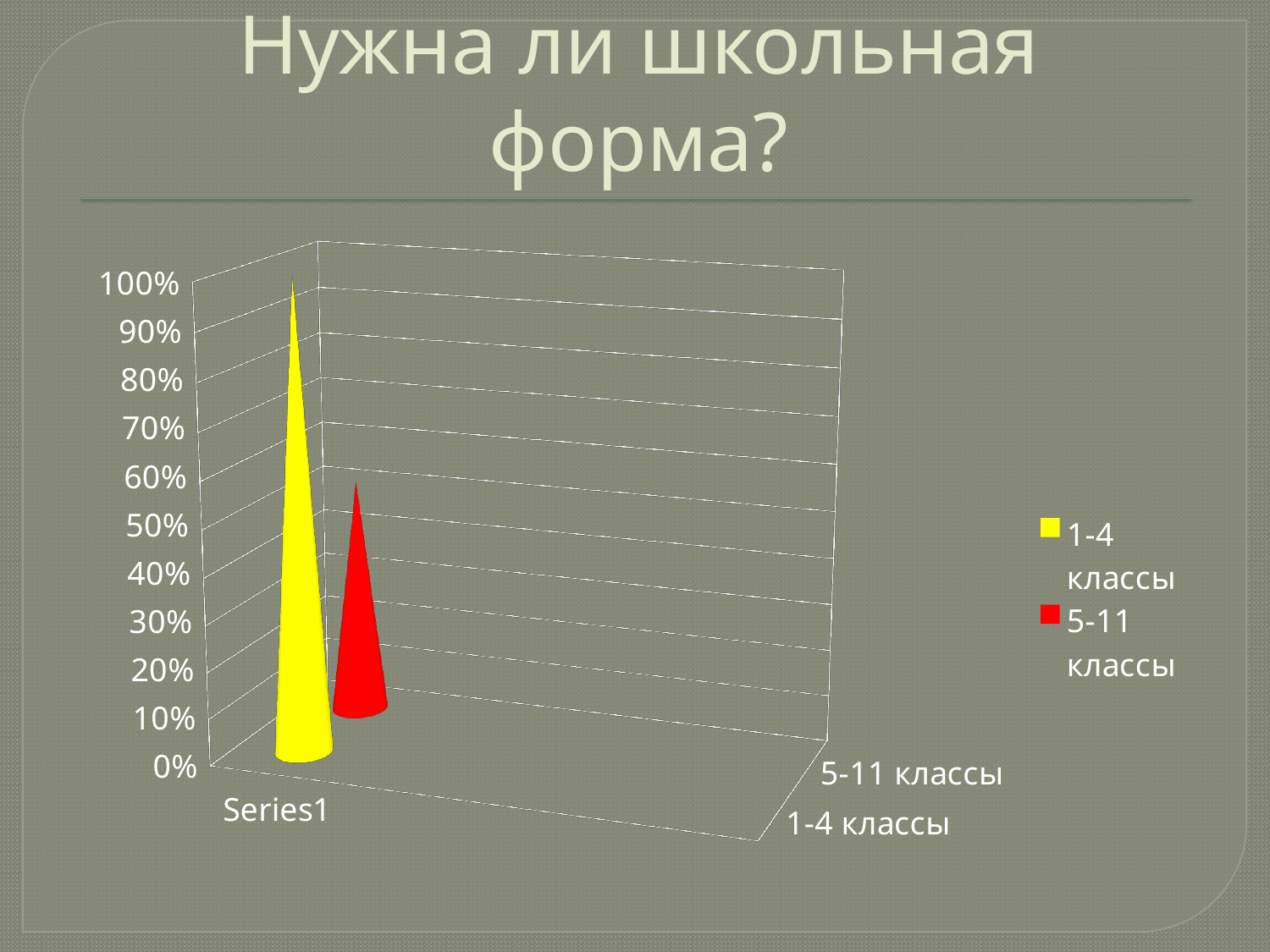
Which series has the lowest value? 5-11 классы What is the title of the slide above the chart? Нужна ли школьная форма? Which series has the higher value: 1-4 классы or 5-11 классы? 1-4 классы How many series does the legend list? 2 Is the value for 5-11 классы greater or less than 30%? greater Is the value for 5-11 классы greater or less than 80%? less What kind of chart is shown on the slide? bar chart Which series has the highest value? 1-4 классы How many categories are shown on the horizontal axis? 1 Is the value for 1-4 классы greater or less than 80%? greater What are the two series named in the legend? 1-4 классы and 5-11 классы What is the label of the category on the horizontal axis? Series1